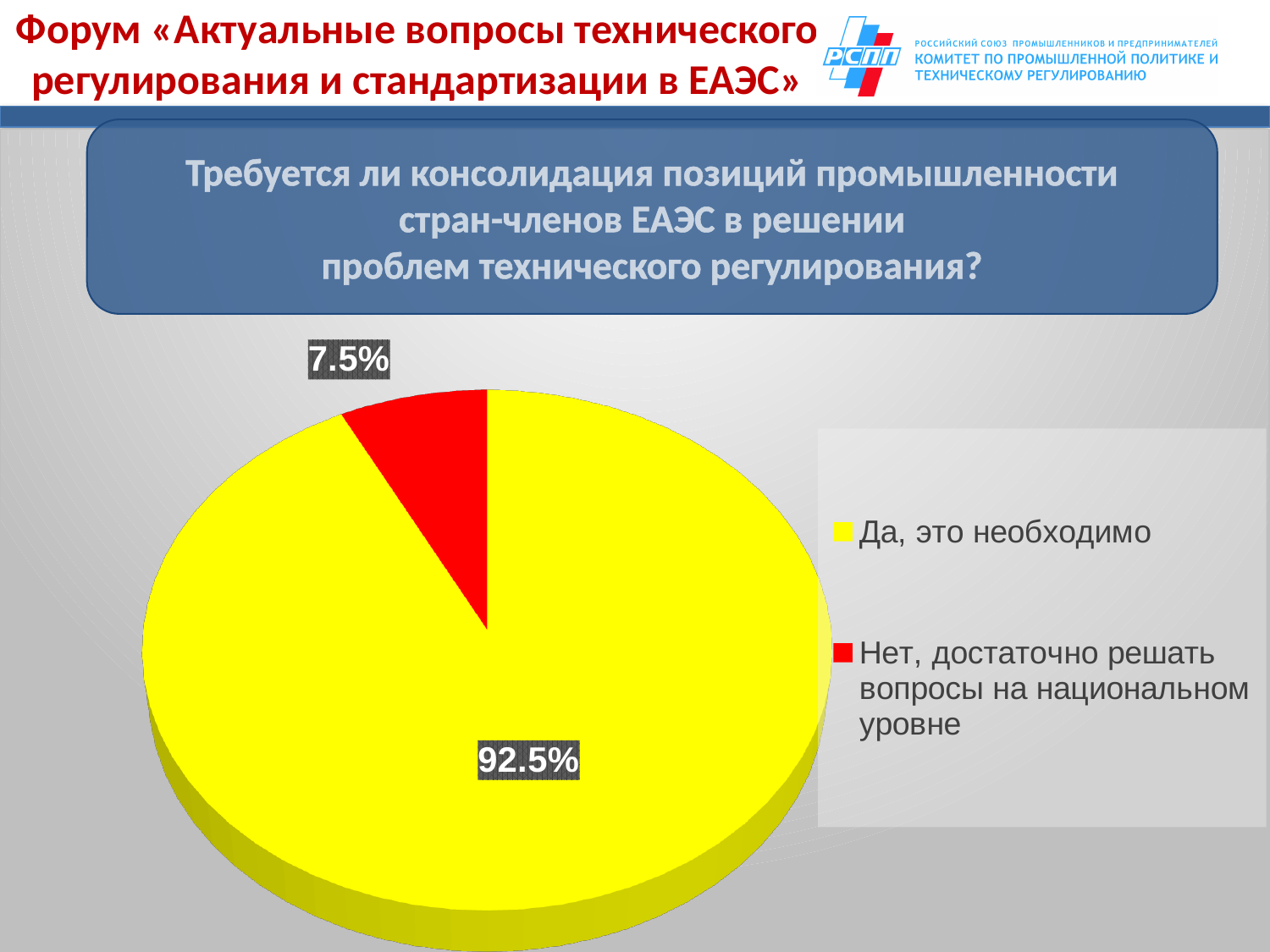
Which slice of the pie is the largest? Да, это необходимо Which slice of the pie is the smallest? Нет, достаточно решать вопросы на национальном уровне What colour is the "Нет, достаточно решать вопросы на национальном уровне" slice? red What share of the pie does "Да, это необходимо" have? 92.5% What colour is the "Да, это необходимо" slice? yellow What share of the pie does "Нет, достаточно решать вопросы на национальном уровне" have? 7.5% Which is larger: the "Да, это необходимо" slice or the "Нет, достаточно решать вопросы на национальном уровне" slice? Да, это необходимо What kind of chart is shown on the slide? pie chart How many entries does the legend list? 2 How many slices does the pie chart have? 2 What is the difference in percentage points between the "Да, это необходимо" slice and the "Нет, достаточно решать вопросы на национальном уровне" slice? 85 percentage points